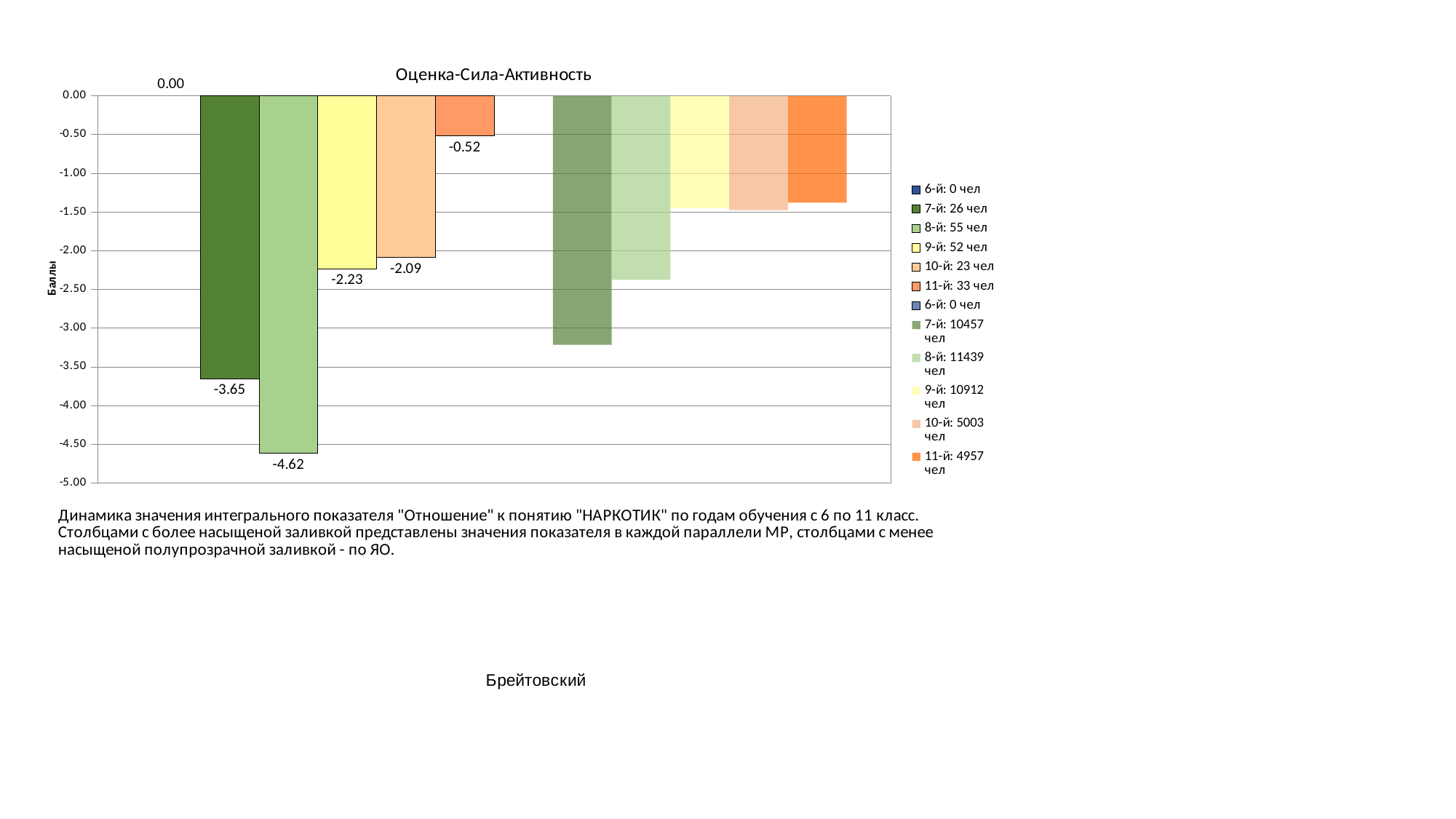
What is the value for the series "7-й: 26 чел"? -3.65 How many series does the legend list? 12 What is the title of the chart? Оценка-Сила-Активность What is the value for the series "10-й: 23 чел"? -2.09 What is the value for the series "8-й: 55 чел"? -4.62 Is the value for "7-й: 10457 чел" greater or less than -3.00? less What kind of chart is shown on the slide? bar chart What is the value for the series "11-й: 33 чел"? -0.52 Is the value for "8-й: 11439 чел" greater or less than -2.00? less What is the difference between the values for "7-й: 26 чел" and "8-й: 55 чел"? 0.97 Which is larger, the value for "9-й: 52 чел" or the value for "10-й: 23 чел"? 10-й: 23 чел Which of the labeled series has the lowest value? 8-й: 55 чел